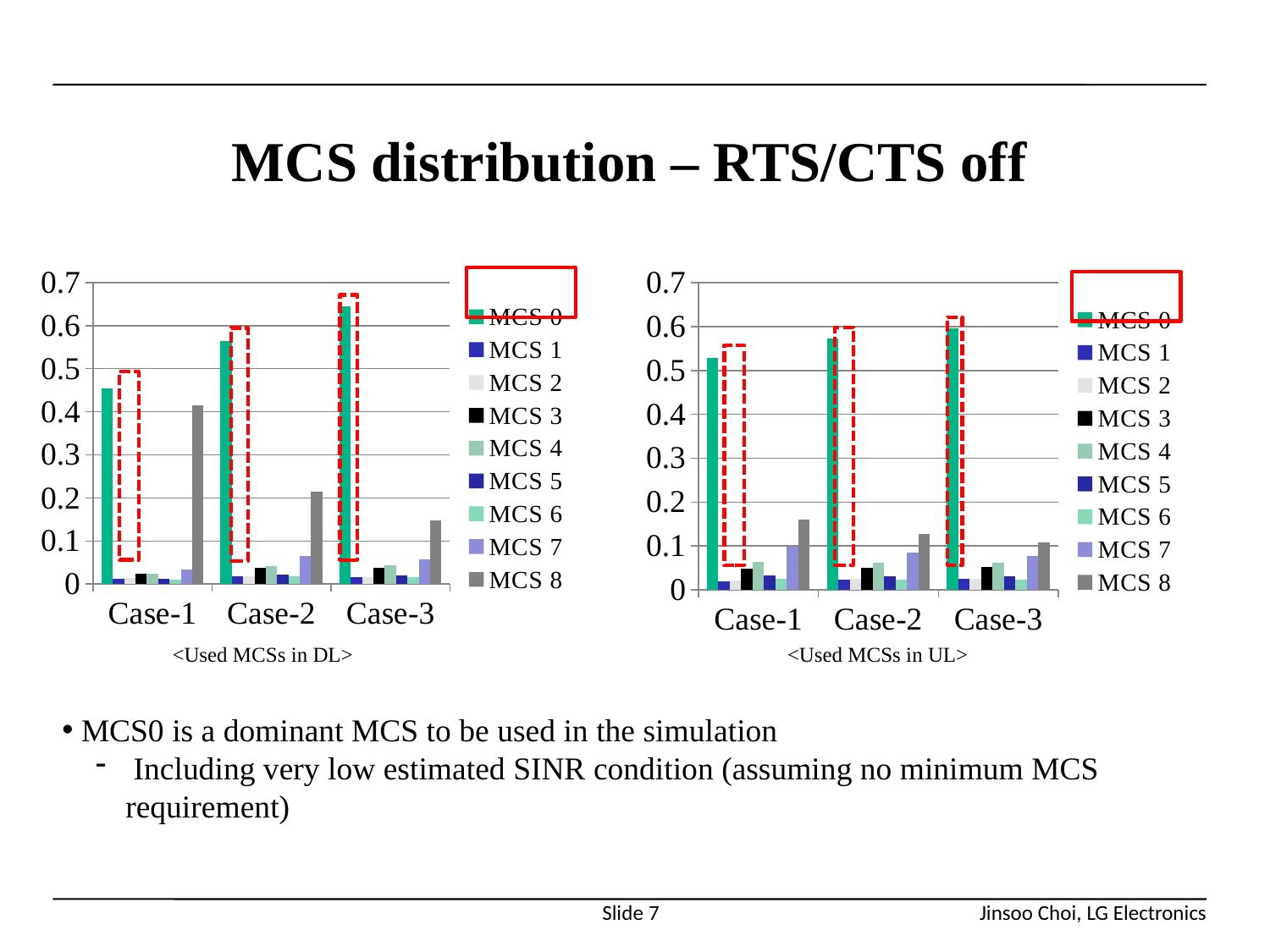
In the <Used MCSs in DL> chart, does the value for MCS 0 rise or fall from Case-1 to Case-3? rise How many series does the legend of the <Used MCSs in UL> chart list? 9 In the <Used MCSs in DL> chart, is the value for MCS 0 in Case-3 greater or less than 0.6? greater What is the title of the slide containing the two charts? MCS distribution – RTS/CTS off In the <Used MCSs in DL> chart, which is larger in Case-2: MCS 0 or MCS 8? MCS 0 How many categories are shown on the x axis of the <Used MCSs in DL> chart? 3 What kind of chart is the <Used MCSs in DL> chart on the left? bar chart In the <Used MCSs in UL> chart, is the value for MCS 8 in Case-1 greater or less than 0.1? greater In the <Used MCSs in UL> chart, is the value for MCS 0 in Case-1 greater or less than 0.5? greater In the <Used MCSs in UL> chart, which series has the highest value in Case-3? MCS 0 In the <Used MCSs in DL> chart, which series has the highest value in Case-2? MCS 0